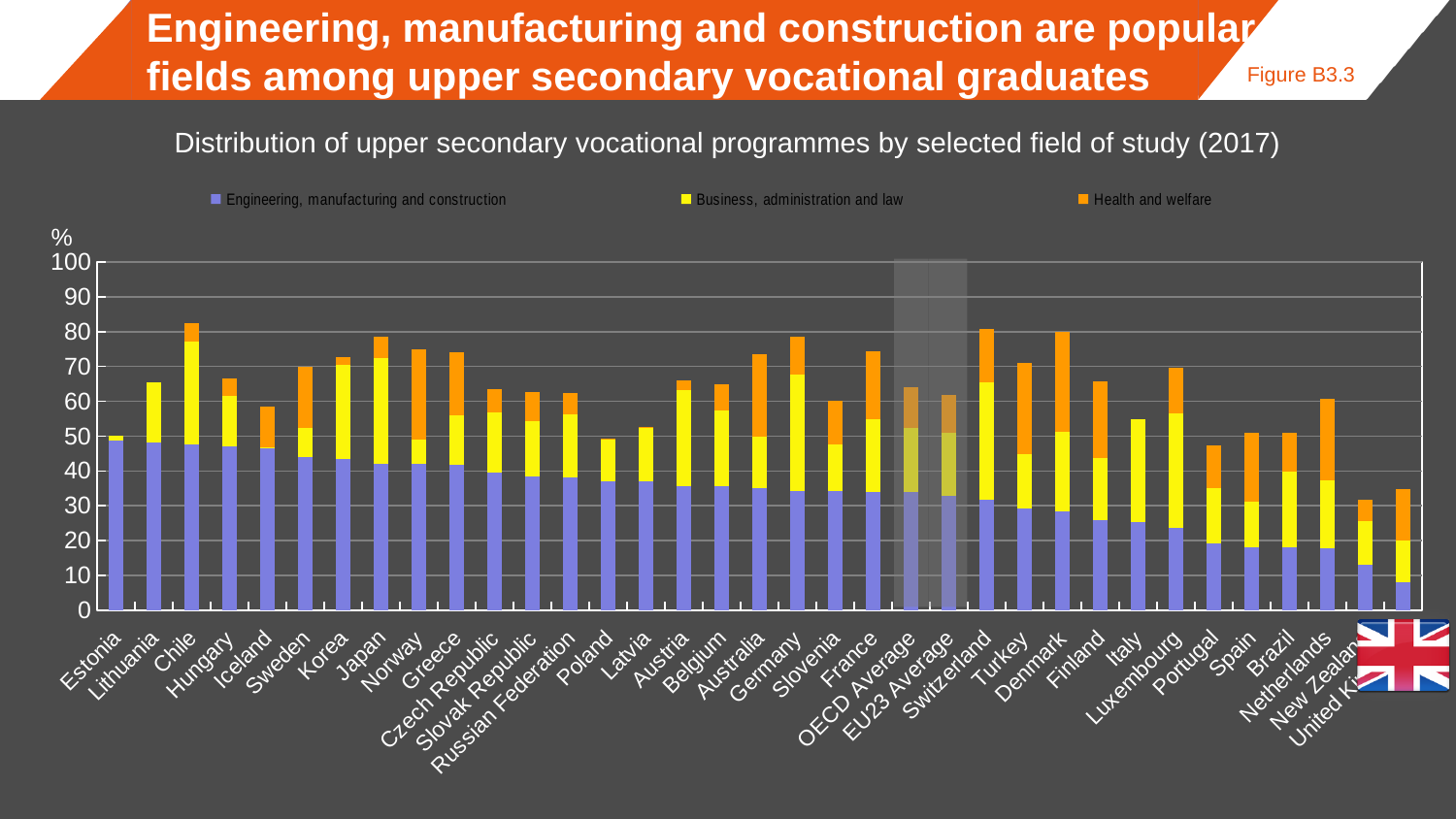
Which series is shown in orange in the legend? Health and welfare Is the Engineering, manufacturing and construction value for Estonia greater or less than 40? greater Which country has the highest value for Engineering, manufacturing and construction? Estonia Is the total stacked value for Chile greater or less than 70? greater What kind of chart is shown on the slide? Stacked bar chart Is the total stacked value for New Zealand greater or less than 40? less Which has the larger total stacked value, Germany or Slovenia? Germany Which has the larger Engineering, manufacturing and construction value, Estonia or Italy? Estonia Does the Engineering, manufacturing and construction series rise or fall from left to right along the x axis? Fall How many series does the legend list? 3